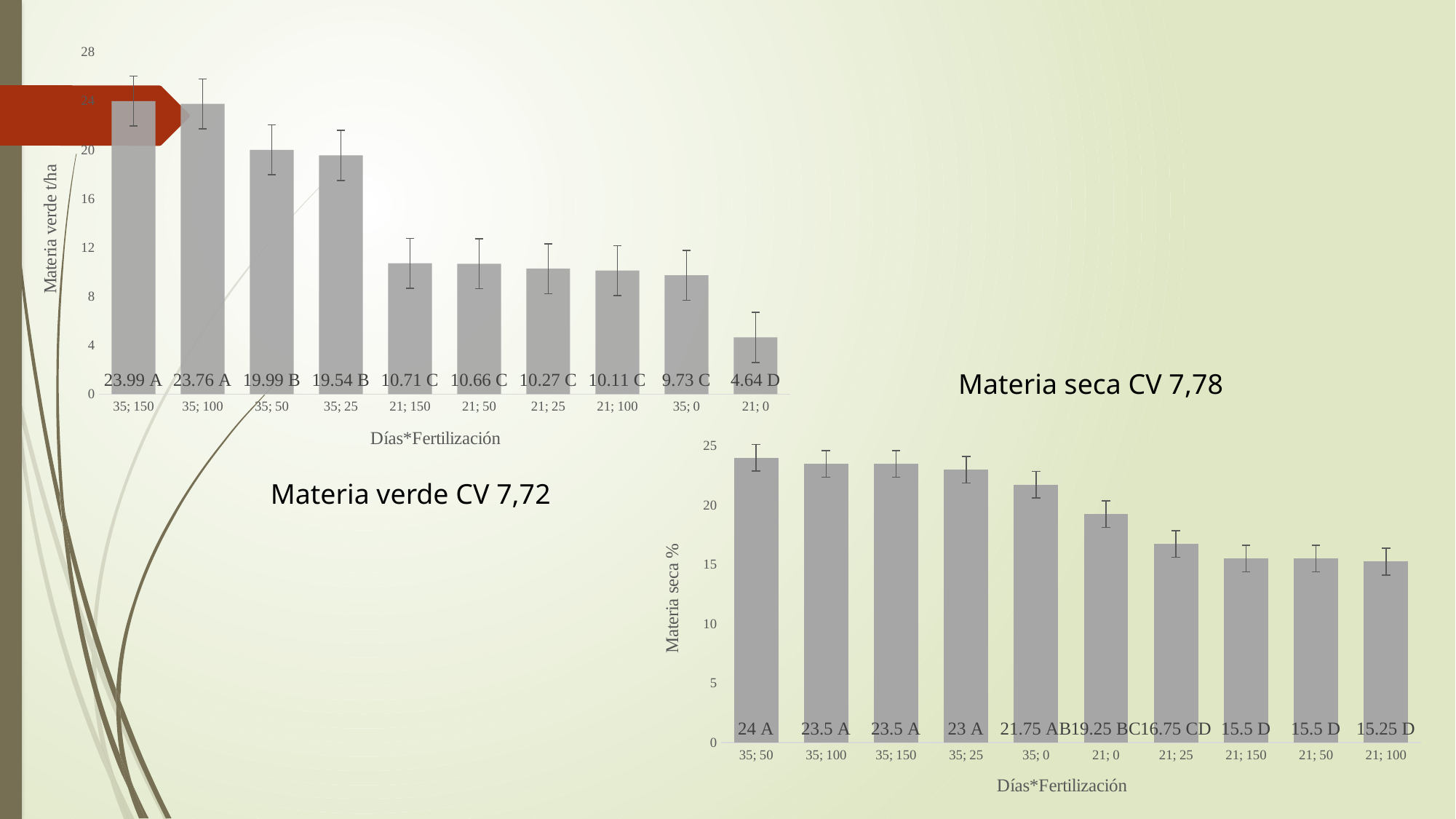
In the Materia seca CV 7,78 chart, is the value for 35; 0 larger than the value for 21; 25? Yes In the Materia verde CV 7,72 chart, what is the y-axis label? Materia verde t/ha In the Materia seca CV 7,78 chart, what is the data label for the 21; 0 bar? 19.25 BC In the Materia verde CV 7,72 chart, which category has the lowest value? 21; 0 In the Materia verde CV 7,72 chart, which category has the highest value? 35; 150 In the Materia verde CV 7,72 chart, what is the data label for the 21; 0 bar? 4.64 D What kind of chart is the Materia seca CV 7,78 chart? Bar chart In the Materia seca CV 7,78 chart, which category has the lowest value? 21; 100 In the Materia seca CV 7,78 chart, what is the data label for the 35; 50 bar? 24 A In the Materia verde CV 7,72 chart, what is the difference between the values for 35; 150 and 21; 0? 19.35 In the Materia verde CV 7,72 chart, how many bars are plotted? 10 In the Materia verde CV 7,72 chart, what is the data label for the 35; 150 bar? 23.99 A